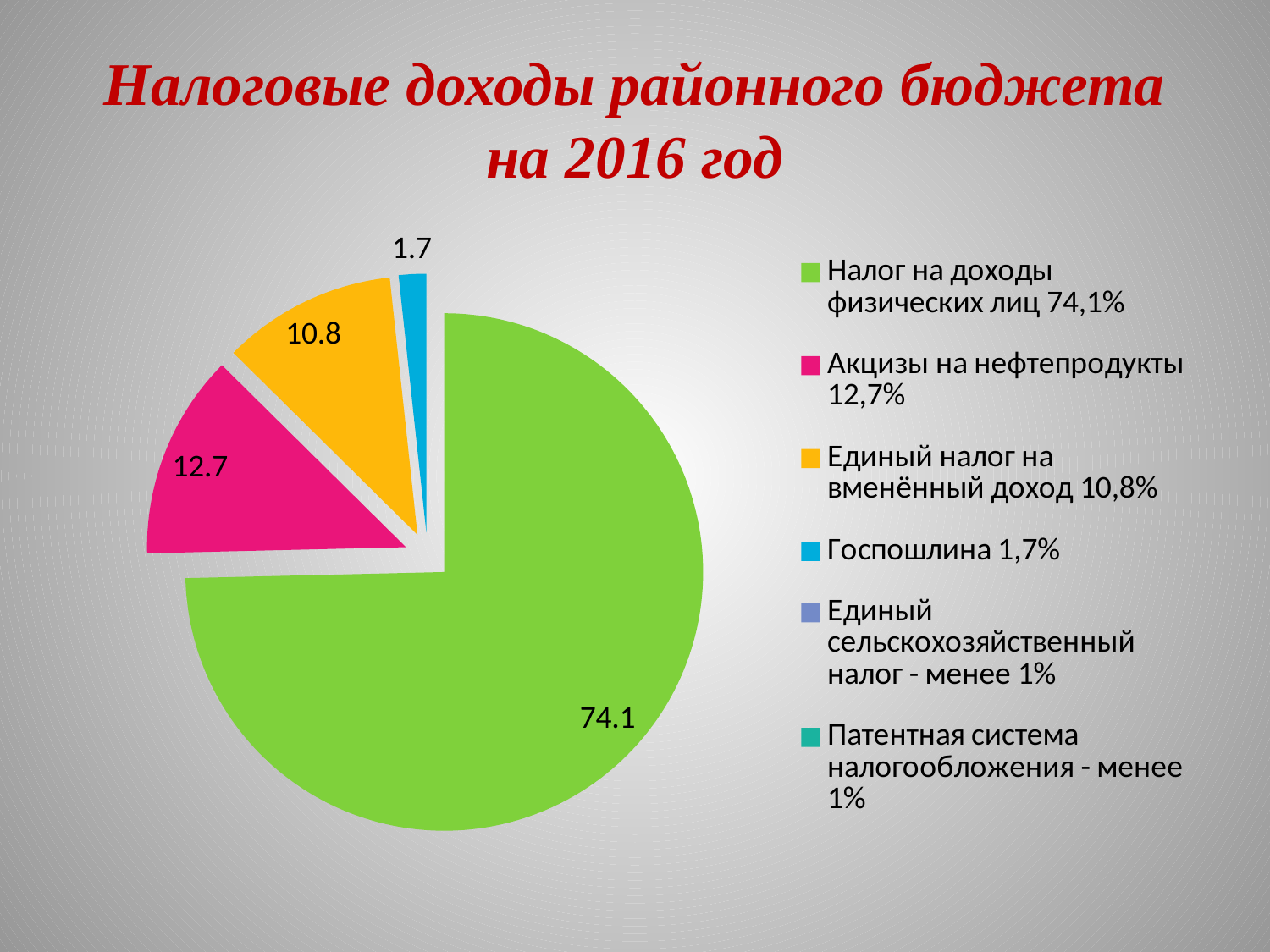
What value is shown for Акцизы на нефтепродукты? 12.7 What value is shown for Налог на доходы физических лиц? 74.1 What is the title of the chart on the slide? Налоговые доходы районного бюджета на 2016 год Which is larger: the value for Акцизы на нефтепродукты or the value for Единый налог на вменённый доход? Акцизы на нефтепродукты Which of the labelled slices is the smallest? Госпошлина Which category has the largest slice of the pie? Налог на доходы физических лиц What is the difference between the values for Акцизы на нефтепродукты and Единый налог на вменённый доход? 1.9 What type of chart is shown on the slide? pie chart How many entries does the legend list? 6 What value is shown for Госпошлина? 1.7 What is the difference between the values for Налог на доходы физических лиц and Акцизы на нефтепродукты? 61.4 What value is shown for Единый налог на вменённый доход? 10.8